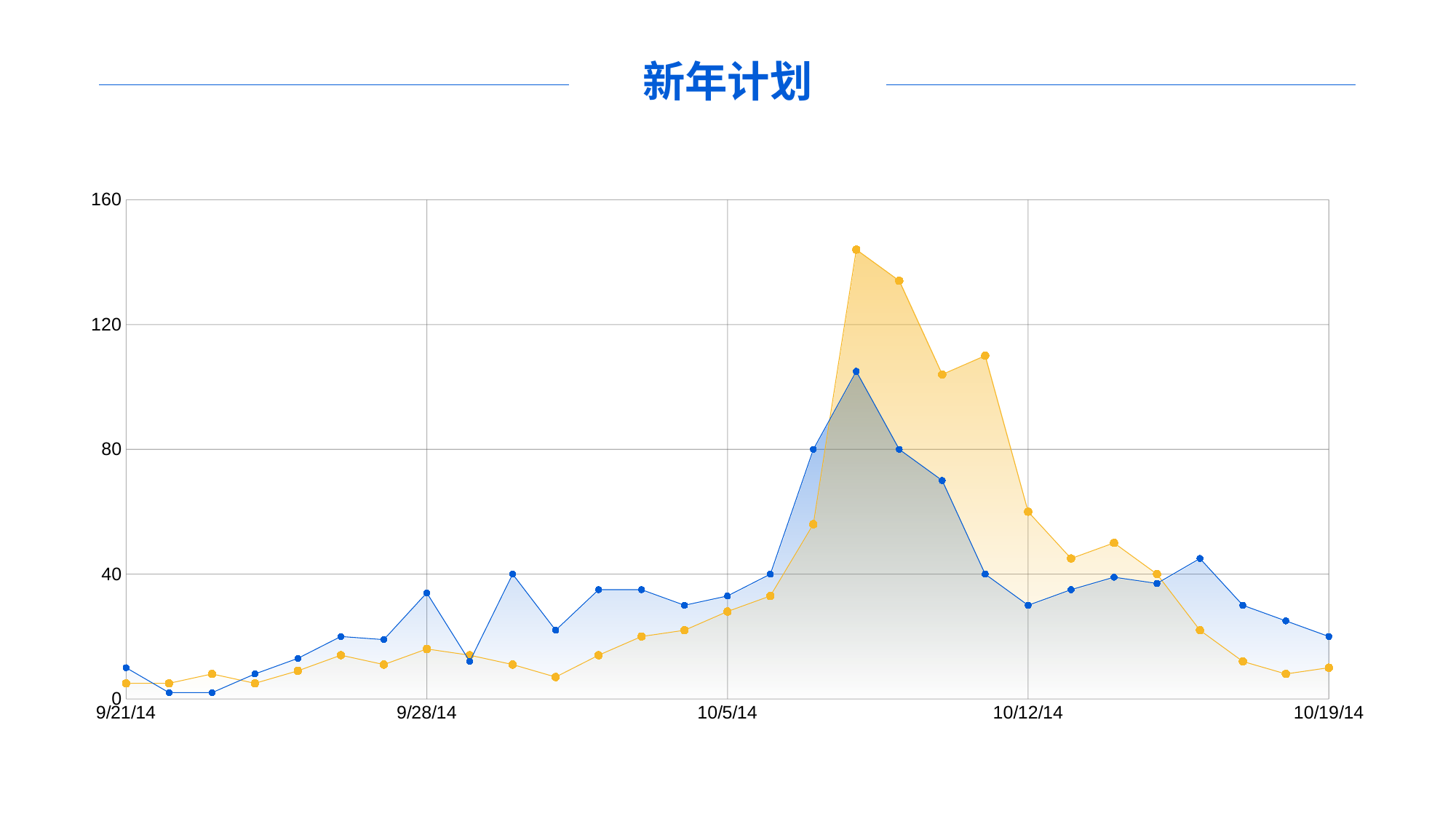
How many date labels are shown on the x axis? 5 What is the title of the slide? 新年计划 Is the value of the blue series at 10/12/14 greater or less than 40? less Is the value of the orange series at its peak greater or less than 120? greater What kind of chart is shown on the slide? line chart Is the value of the orange series at 10/19/14 greater or less than 40? less At 9/28/14, which series has the larger value, the blue or the orange? blue Which series reaches the highest value on the chart, the blue or the orange? orange At 10/12/14, which series has the larger value, the blue or the orange? orange How many data series are plotted on the chart? 2